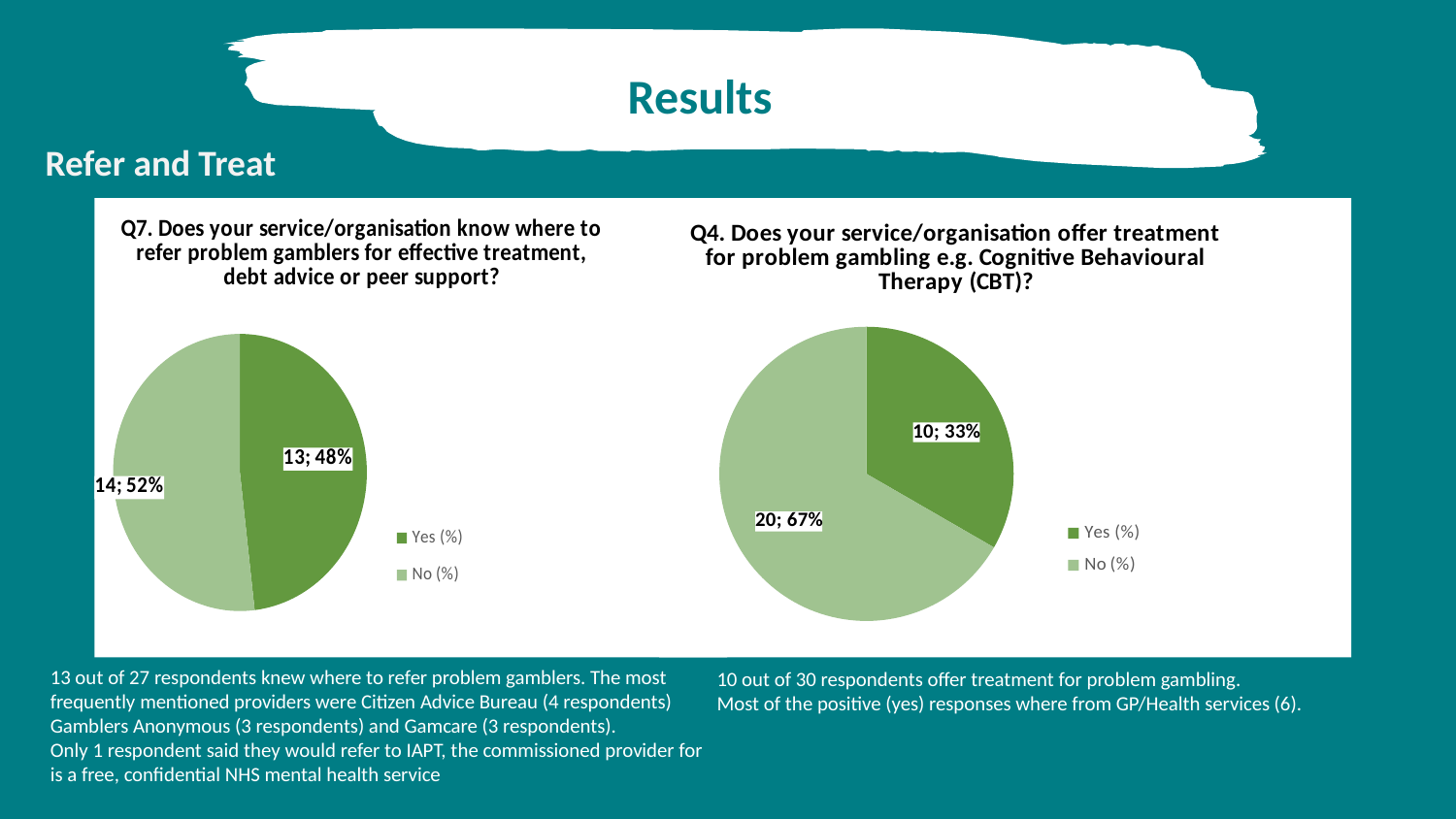
In the Q7 chart (left), what share of the pie does the No (%) slice represent? 52% What type of chart is used for Q4 (right)? Pie chart In the Q4 chart (right), what is the difference in count between the No and Yes slices? 10 In the Q4 chart (right), what is the data label for the No (%) slice? 20; 67% In the Q4 chart (right), which slice is the largest? No (%) How many entries does the legend of the Q7 chart (left) list? 2 In the Q4 chart (right), what is the total count across both slices? 30 In the Q4 chart (right), which slice is the smallest? Yes (%) In the Q7 chart (left), what is the data label for the No (%) slice? 14; 52% In the Q7 chart (left), what is the data label for the Yes (%) slice? 13; 48% In the Q4 chart (right), what is the data label for the Yes (%) slice? 10; 33% In the Q7 chart (left), what is the difference in count between the No and Yes slices? 1